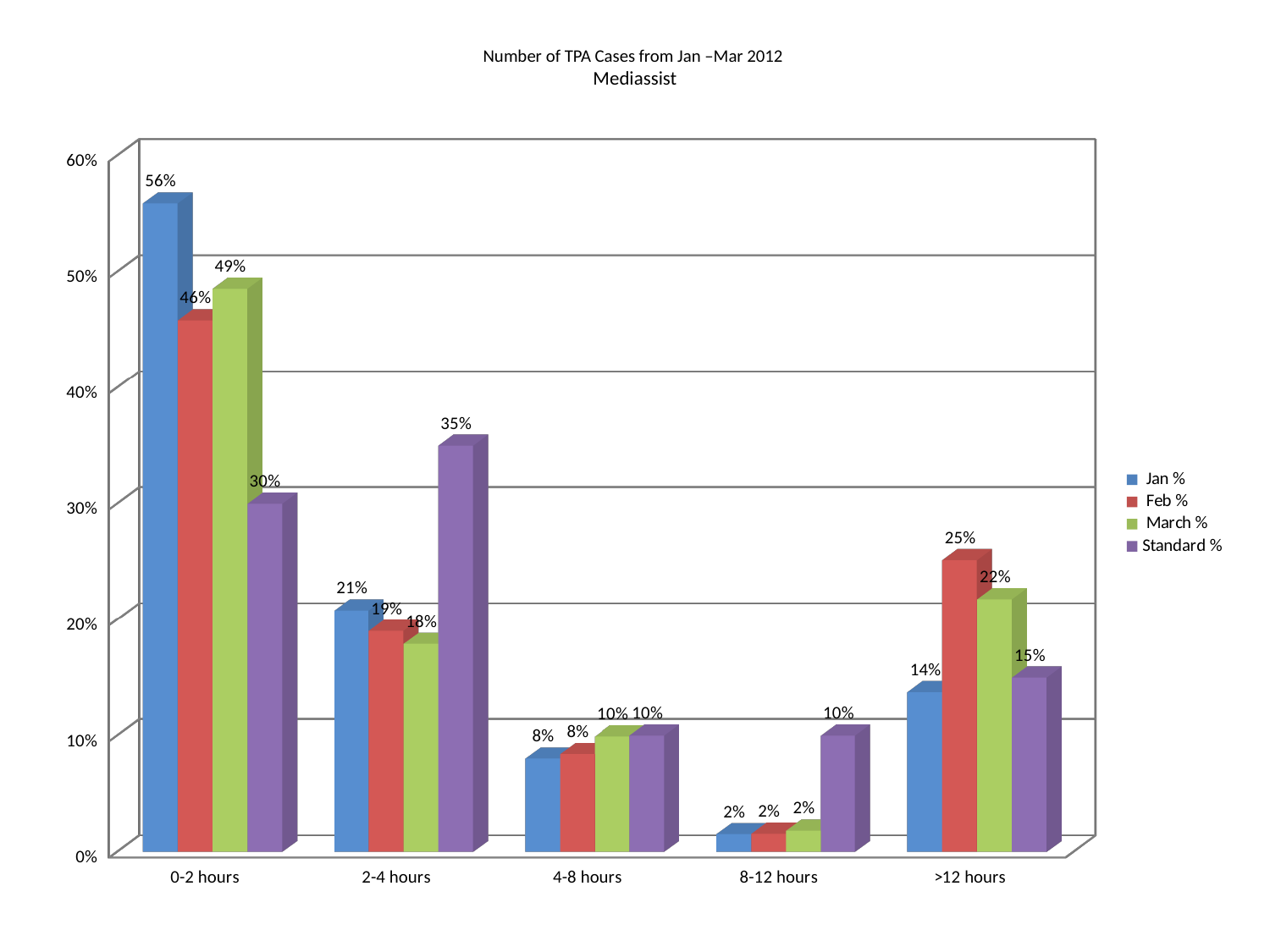
What is the Standard % value for 2-4 hours? 35% What is the Jan % value for 0-2 hours? 56% Which category has the highest Jan % value? 0-2 hours What is the March % value for 4-8 hours? 10% What is the Feb % value for >12 hours? 25% What is the difference between the Jan % and Standard % values for 0-2 hours? 26% What kind of chart is shown on the slide? Bar chart Which category has the lowest Standard % value? 8-12 hours How many categories are shown on the x axis? 5 What is the title of the chart? Number of TPA Cases from Jan –Mar 2012 Mediassist How many series does the legend list? 4 For >12 hours, which is larger: Feb % or March %? Feb %